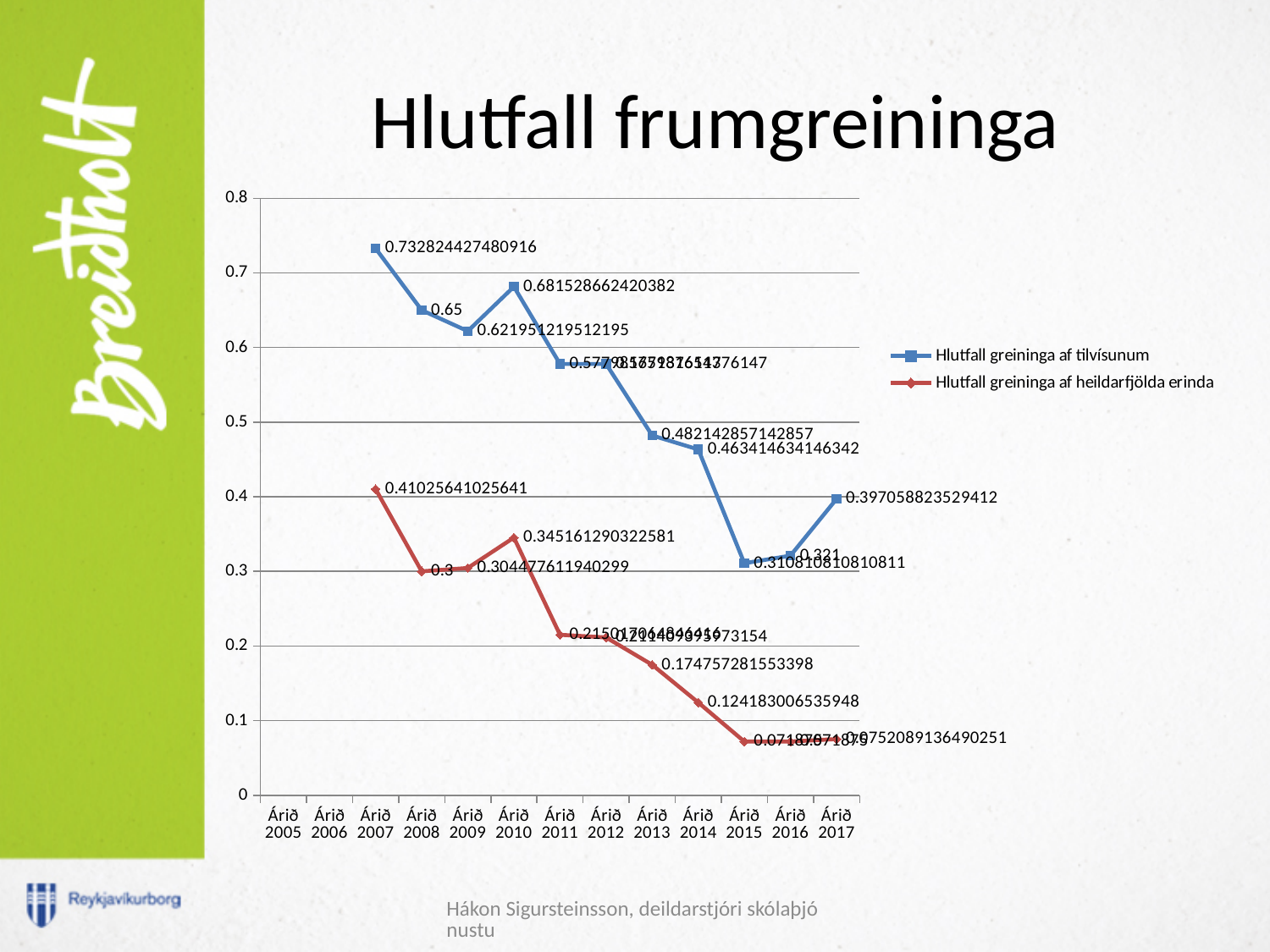
How many series does the legend list? 2 In which year is 'Hlutfall greininga af tilvísunum' highest? Árið 2007 In which year is 'Hlutfall greininga af tilvísunum' lowest? Árið 2015 What is the value of 'Hlutfall greininga af heildarfjölda erinda' for Árið 2010? 0.345161290322581 For 'Hlutfall greininga af tilvísunum', which is larger: Árið 2013 or Árið 2014? Árið 2013 What is the difference between the two series' values for Árið 2008? 0.35 What is the value of 'Hlutfall greininga af heildarfjölda erinda' for Árið 2014? 0.124183006535948 Is the value of 'Hlutfall greininga af heildarfjölda erinda' for Árið 2013 greater or less than 0.2? less What type of chart is shown on the slide? line chart What is the value of 'Hlutfall greininga af tilvísunum' for Árið 2008? 0.65 How many year categories are shown on the x axis? 13 What is the value of 'Hlutfall greininga af tilvísunum' for Árið 2007? 0.732824427480916